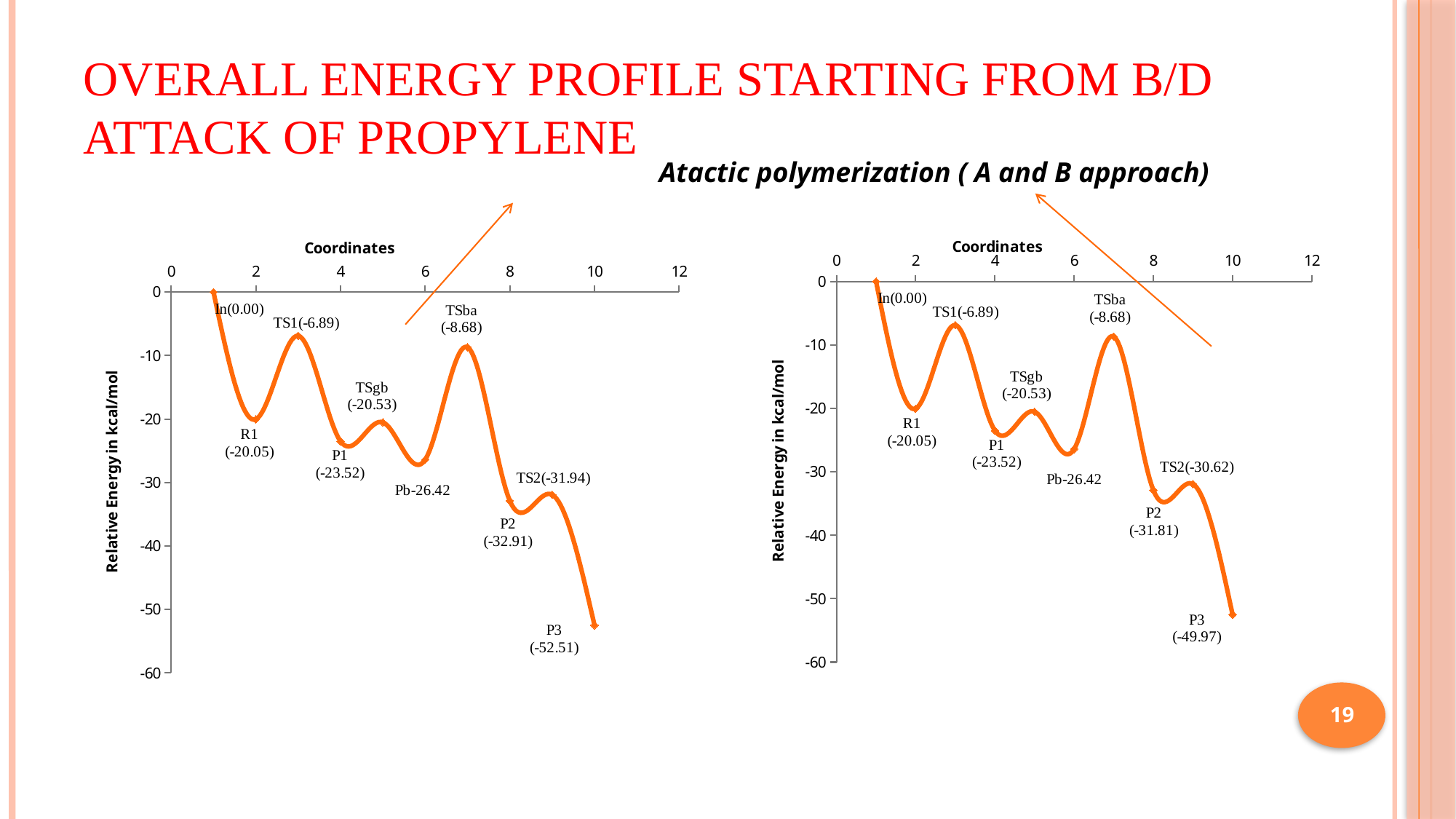
In the left chart, what is the relative energy of TS2? -31.94 How many labeled points are there in the right chart? 10 In the right chart, which labeled point has the lowest relative energy? P3 In the right chart, what is the relative energy of P2? -31.81 In the left chart, which labeled point has the highest relative energy? In What is the y-axis label of the left chart? Relative Energy in kcal/mol In the left chart, which is lower in energy, TS1 or TSba? TSba In the left chart, what is the relative energy of P3? -52.51 What type of chart is shown on the left? Line chart In the left chart, what is the relative energy of TSba? -8.68 What is the difference between the P3 energy in the left chart (-52.51) and the P3 energy in the right chart (-49.97)? 2.54 In the right chart, what is the relative energy of P3? -49.97